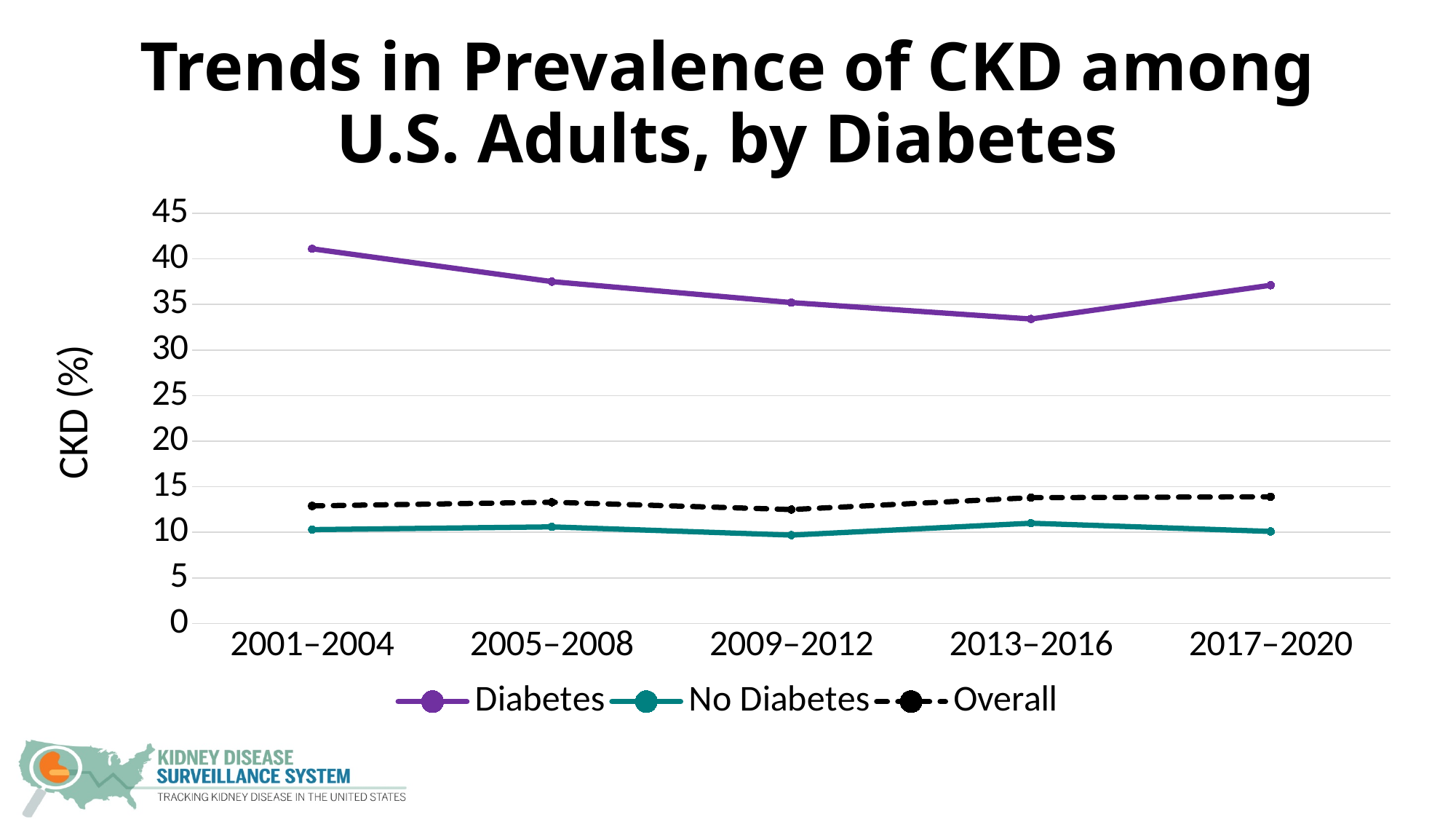
Does the Diabetes series rise or fall from 2001–2004 to 2013–2016? fall Which series has the lowest CKD prevalence across all periods? No Diabetes Is the value for Diabetes in 2001–2004 greater or less than 40? greater Which series has the highest CKD prevalence across all periods? Diabetes How many time periods are shown on the x axis? 5 Is the value for Diabetes in 2013–2016 greater or less than 35? less In which period is the Diabetes series at its highest? 2001–2004 What kind of chart is shown on the slide? line chart In which period is the Diabetes series at its lowest? 2013–2016 What is the label of the y axis? CKD (%) How many series does the legend list? 3